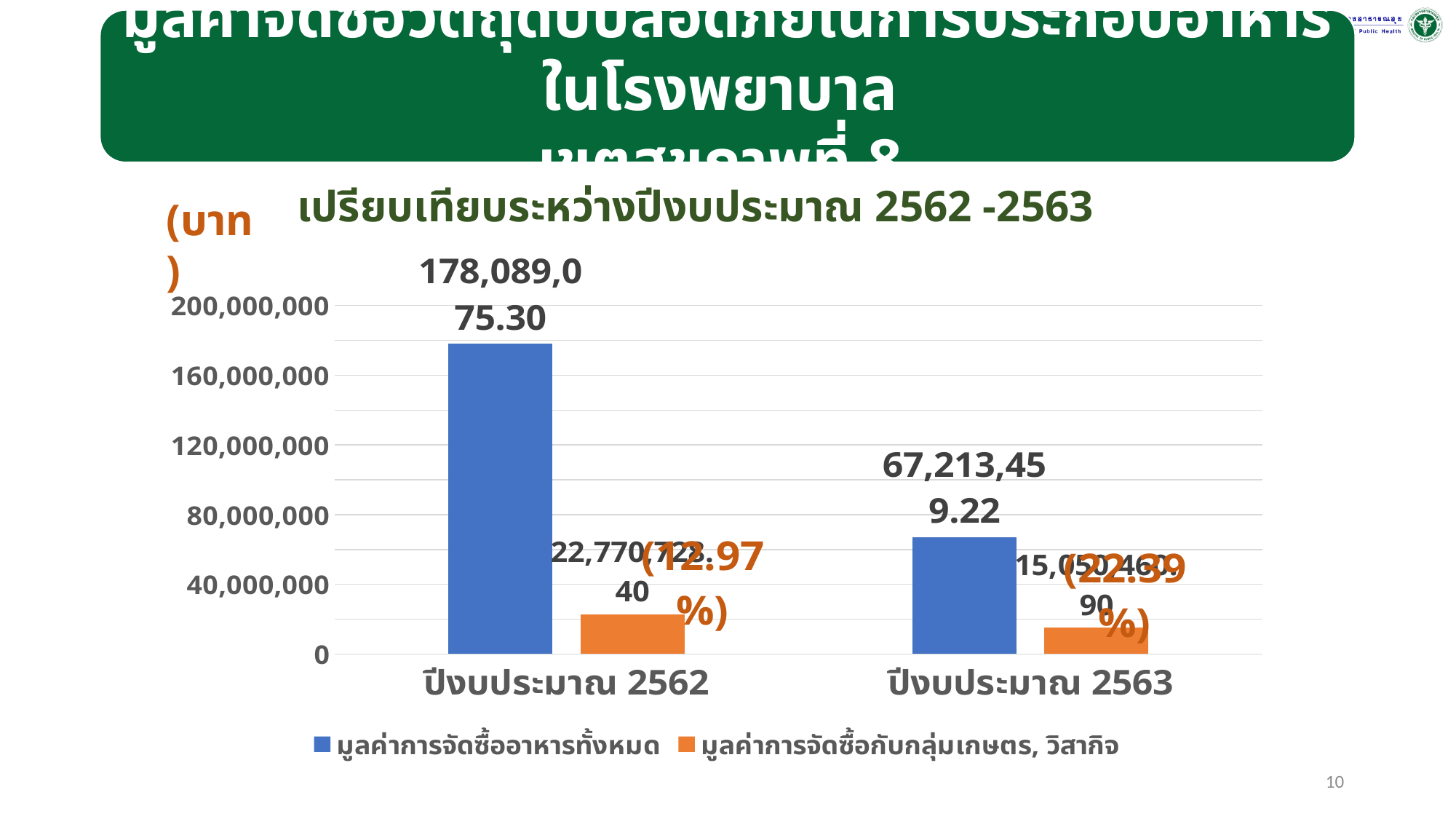
What is the value of มูลค่าการจัดซื้ออาหารทั้งหมด for ปีงบประมาณ 2563? 67,213,459.22 How many series does the chart legend list? 2 Is the value for มูลค่าการจัดซื้ออาหารทั้งหมด in ปีงบประมาณ 2563 greater or less than 80,000,000? less Does มูลค่าการจัดซื้ออาหารทั้งหมด rise or fall from ปีงบประมาณ 2562 to ปีงบประมาณ 2563? fall What percentage is annotated next to the orange bar for ปีงบประมาณ 2563? 22.39% What is the value of มูลค่าการจัดซื้ออาหารทั้งหมด for ปีงบประมาณ 2562? 178,089,075.30 What kind of chart is shown on the slide? bar chart Is the value for มูลค่าการจัดซื้อกับกลุ่มเกษตร, วิสาหกิจ in ปีงบประมาณ 2562 greater or less than 40,000,000? less Which fiscal year has the higher มูลค่าการจัดซื้ออาหารทั้งหมด? ปีงบประมาณ 2562 Which is larger: มูลค่าการจัดซื้อกับกลุ่มเกษตร, วิสาหกิจ in ปีงบประมาณ 2562 or in ปีงบประมาณ 2563? ปีงบประมาณ 2562 How many fiscal years are shown on the x axis of the chart? 2 What is the difference between the มูลค่าการจัดซื้ออาหารทั้งหมด values for ปีงบประมาณ 2562 and ปีงบประมาณ 2563? 110,875,616.08